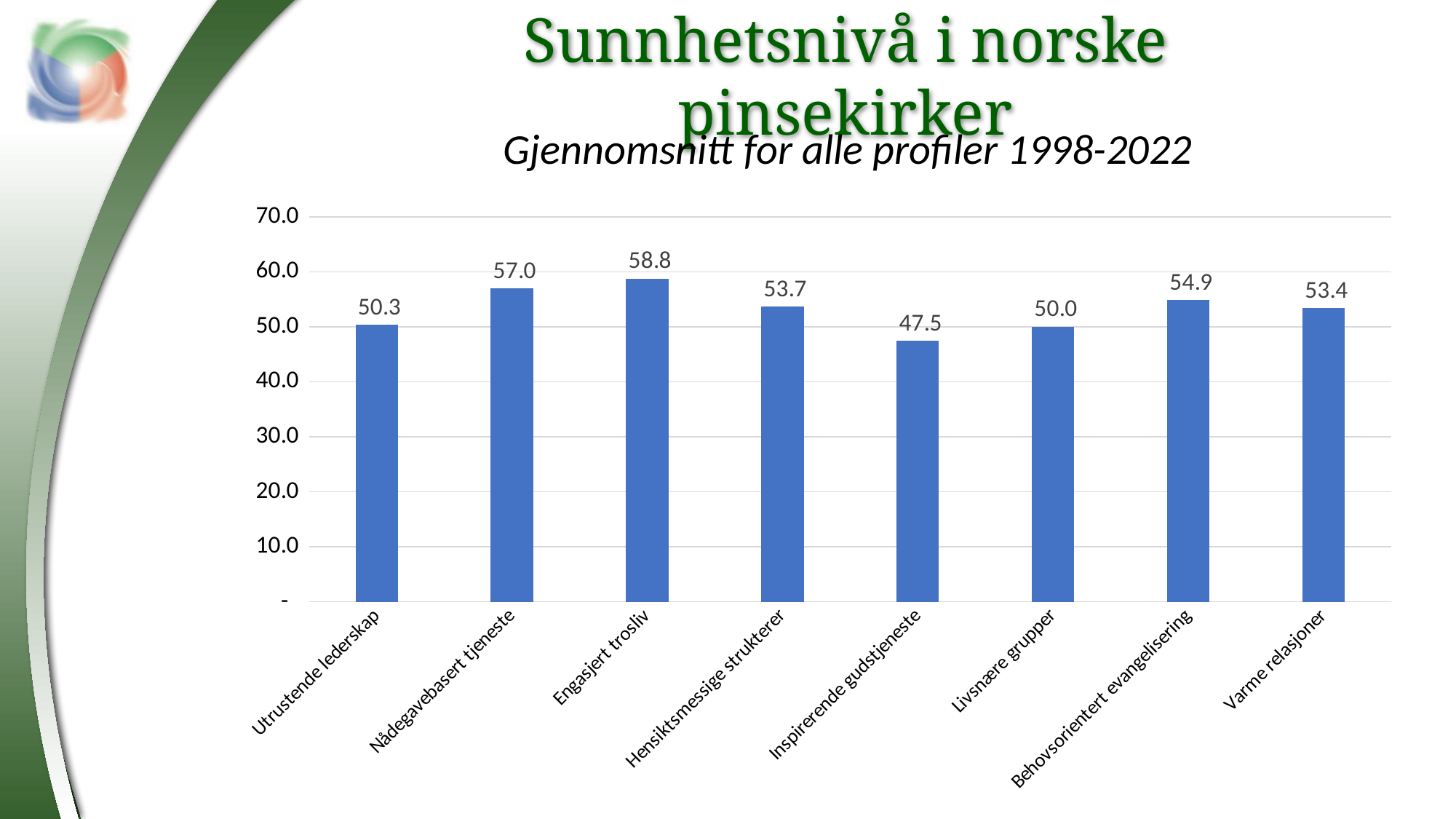
What is the title of the chart? Gjennomsnitt for alle profiler 1998-2022 What is the difference between the values for Engasjert trosliv and Inspirerende gudstjeneste? 11.3 What kind of chart is shown on the slide? Bar chart What is the value for Engasjert trosliv? 58.8 What is the value for Livsnære grupper? 50.0 What is the difference between the values for Nådegavebasert tjeneste and Utrustende lederskap? 6.7 What is the value for Behovsorientert evangelisering? 54.9 Which category has the lowest value? Inspirerende gudstjeneste How many categories are shown in the chart? 8 Which category has the highest value? Engasjert trosliv What is the value for Inspirerende gudstjeneste? 47.5 Which is larger, the value for Hensiktsmessige strukterer or the value for Varme relasjoner? Hensiktsmessige strukterer